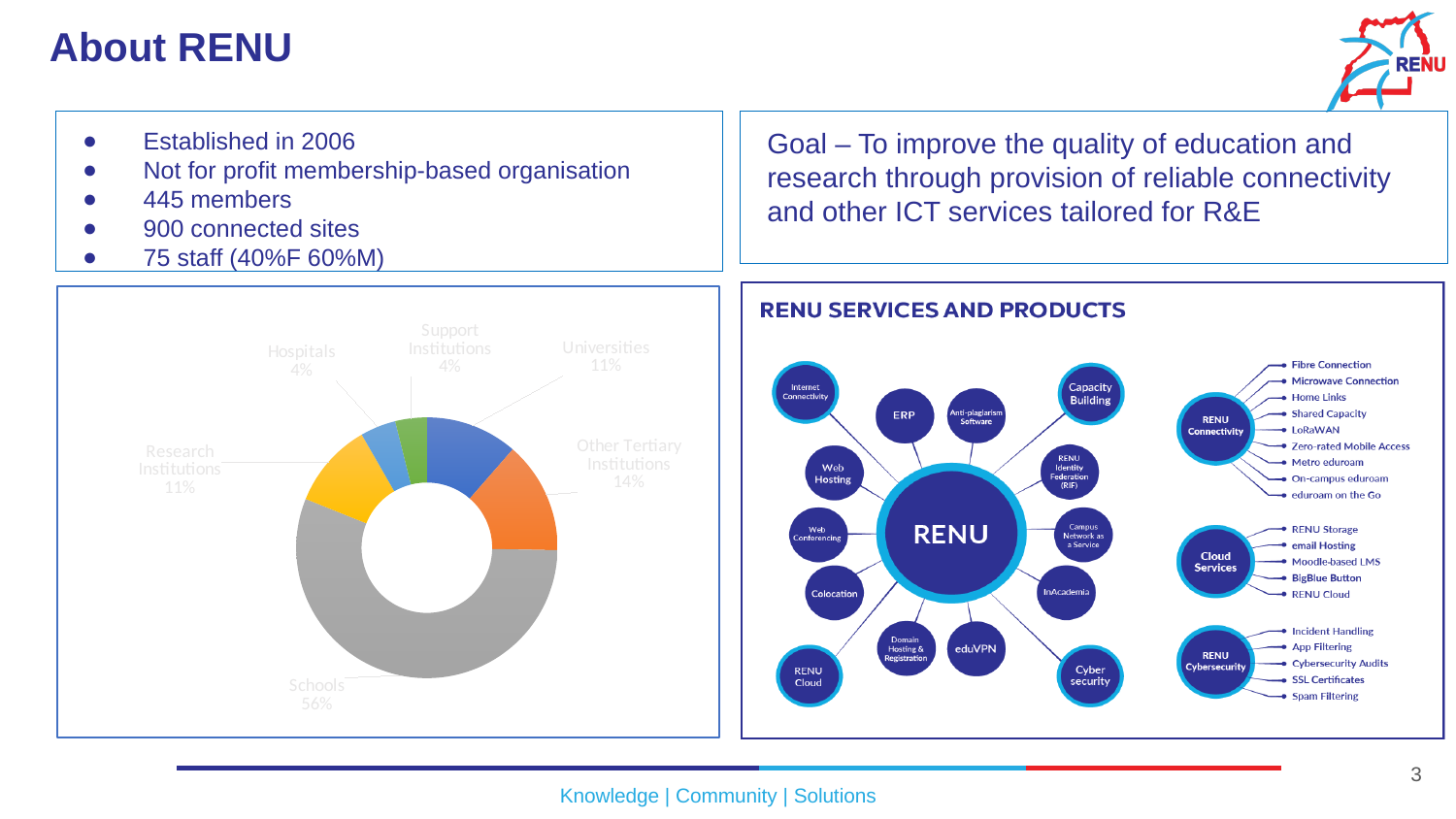
In the donut chart, what is the combined share of Hospitals and Support Institutions? 8% In the donut chart, what is the difference between the share for Schools and the share for Other Tertiary Institutions? 42% In the donut chart, what share do Other Tertiary Institutions account for? 14% In the donut chart, what share do Hospitals account for? 4% In the donut chart, what share do Research Institutions account for? 11% In the donut chart, what share do Universities account for? 11% In the donut chart, what share do Schools account for? 56% Which category has the largest share in the donut chart? Schools What kind of chart is shown on the left of the slide? Donut (pie) chart How many categories are shown in the donut chart? 6 In the donut chart, which is larger: Other Tertiary Institutions or Universities? Other Tertiary Institutions What colour is the Schools segment in the donut chart? Grey